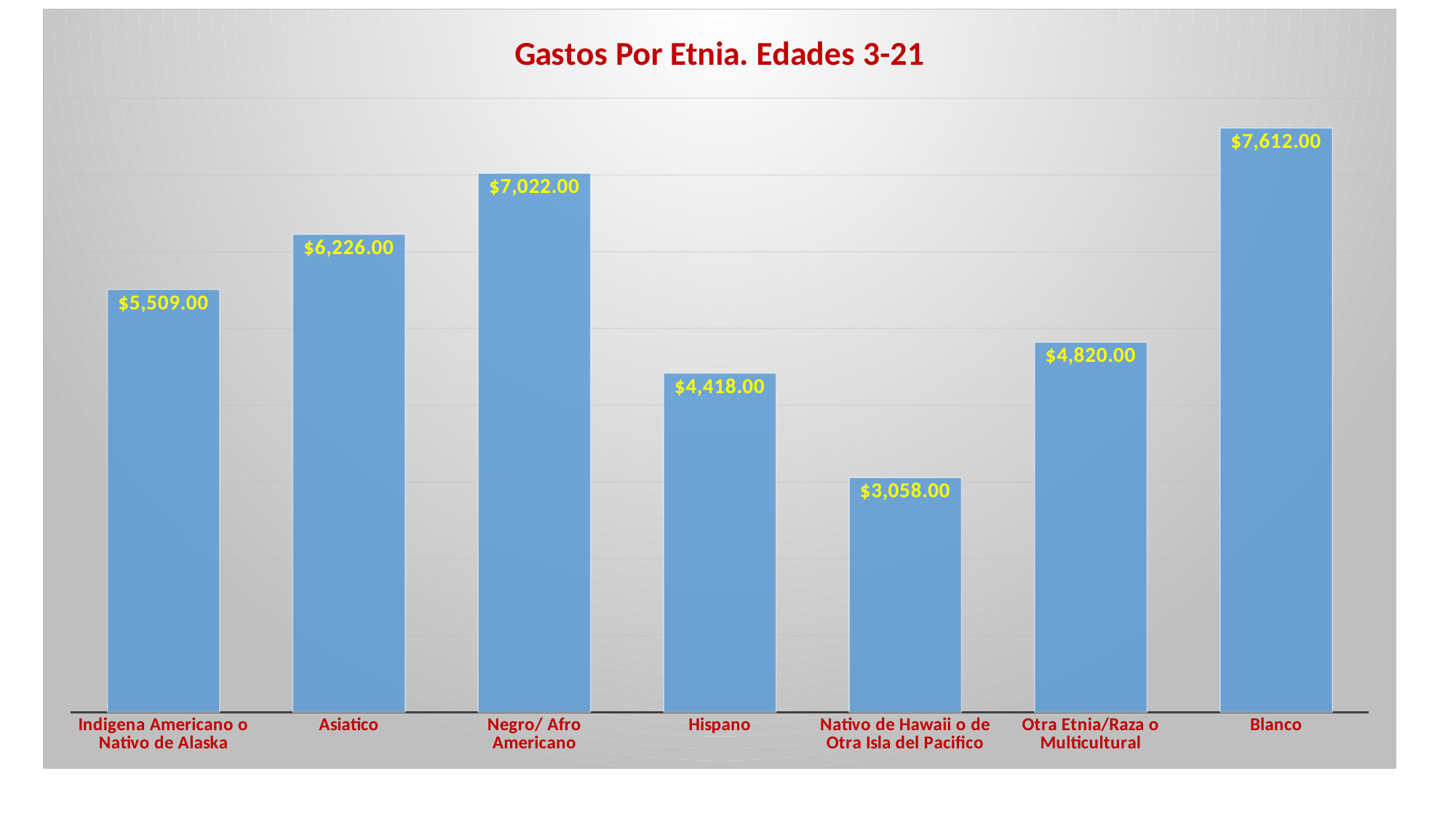
What kind of chart is this? Bar chart What is the title of the chart? Gastos Por Etnia. Edades 3-21 How many categories are shown in the chart? 7 What is the value for Nativo de Hawaii o de Otra Isla del Pacifico? $3,058.00 Which category has the lowest value? Nativo de Hawaii o de Otra Isla del Pacifico What is the difference between the values for Blanco and Negro/ Afro Americano? $590.00 What is the value for Hispano? $4,418.00 What is the difference between the values for Indigena Americano o Nativo de Alaska and Hispano? $1,091.00 Which category has the highest value? Blanco What is the value for Asiatico? $6,226.00 Which is larger, the value for Otra Etnia/Raza o Multicultural or the value for Hispano? Otra Etnia/Raza o Multicultural What colour are the bars in the chart? Blue